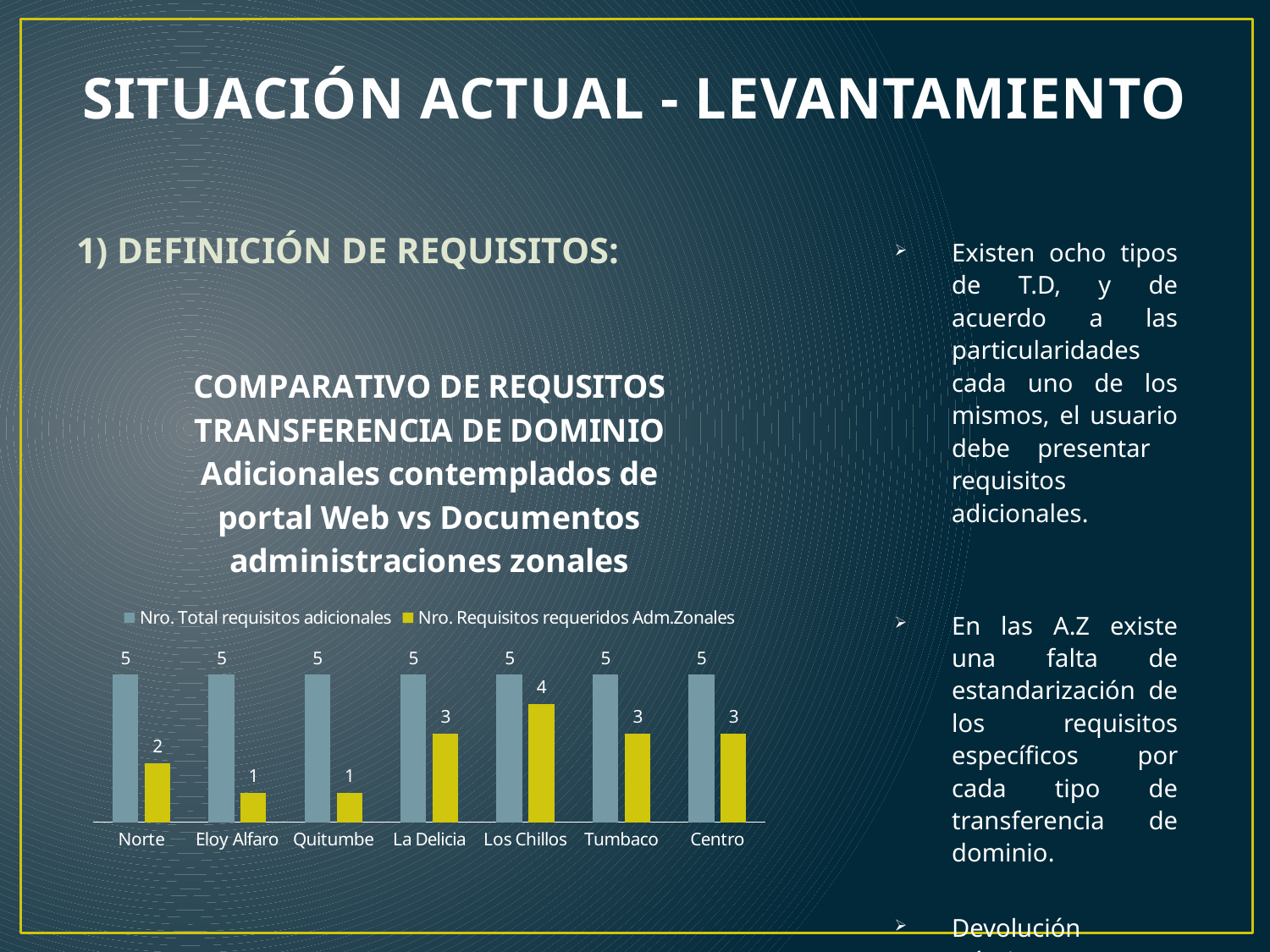
How many series does the chart legend list? 2 Which category has the highest value for 'Nro. Requisitos requeridos Adm.Zonales'? Los Chillos What type of chart is shown on the slide? Bar chart What is the value of 'Nro. Requisitos requeridos Adm.Zonales' for Los Chillos? 4 What is the value of 'Nro. Requisitos requeridos Adm.Zonales' for Eloy Alfaro? 1 How many zonal administrations (categories) are shown on the x axis of the chart? 7 What is the difference between the 'Nro. Requisitos requeridos Adm.Zonales' values for Los Chillos and Quitumbe? 3 What is the value of 'Nro. Total requisitos adicionales' for Tumbaco? 5 What is the value of 'Nro. Requisitos requeridos Adm.Zonales' for Norte? 2 Which is larger for Centro: 'Nro. Total requisitos adicionales' or 'Nro. Requisitos requeridos Adm.Zonales'? Nro. Total requisitos adicionales What is the difference between 'Nro. Total requisitos adicionales' and 'Nro. Requisitos requeridos Adm.Zonales' for La Delicia? 2 Which colour represents the series 'Nro. Requisitos requeridos Adm.Zonales' in the chart? Yellow